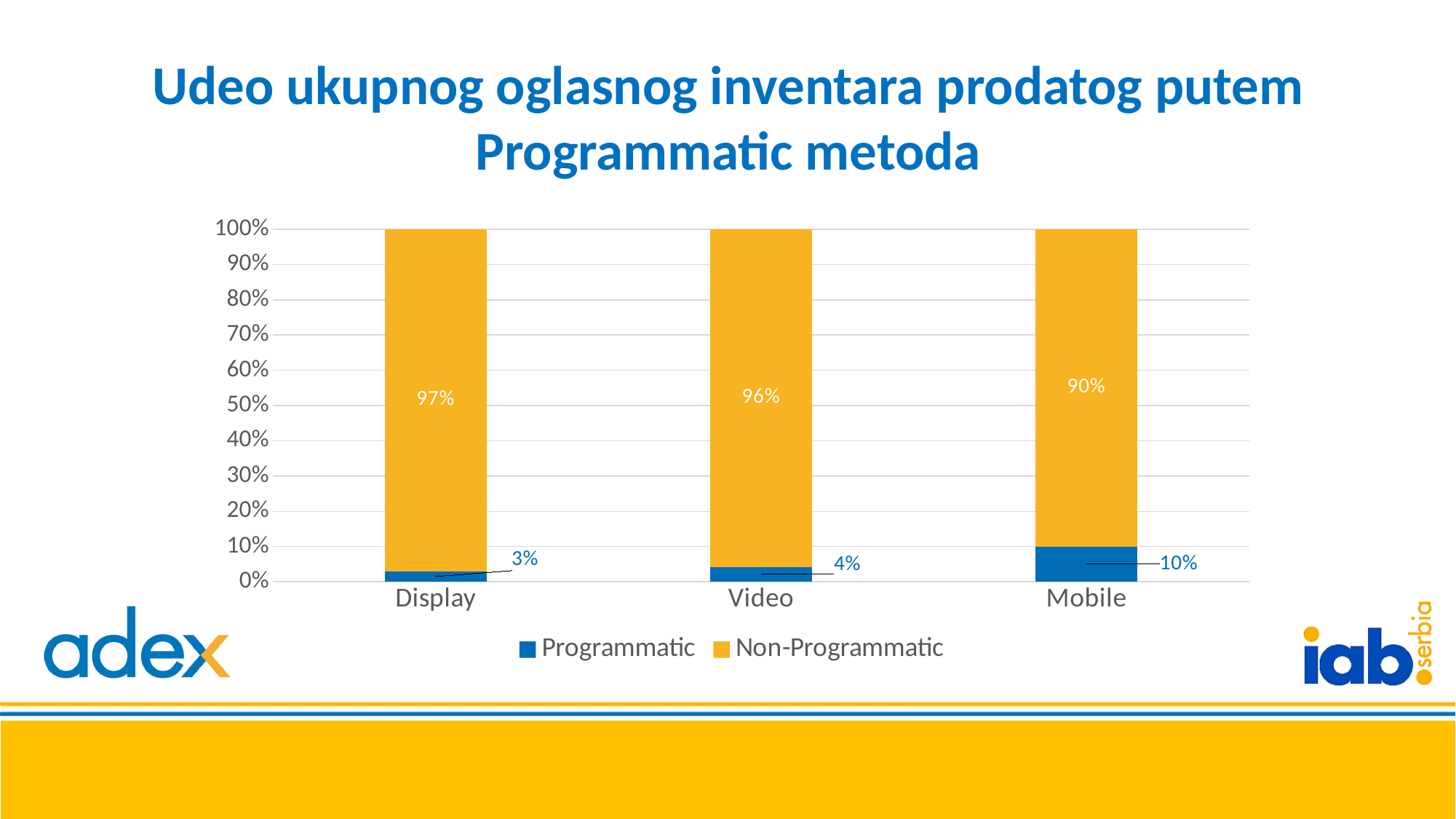
Which category has the highest Programmatic share? Mobile What is the difference between the Programmatic share for Mobile and for Display? 7% What is the total of the stacked bar for Video? 100% How many categories are shown on the x axis? 3 Which is larger, the Non-Programmatic share for Display or for Video? Display Which category has the lowest Programmatic share? Display How many series does the legend list? 2 What is the Programmatic share for Mobile? 10% What is the Programmatic share for Video? 4% What is the Non-Programmatic share for Display? 97% What kind of chart is shown on the slide? Stacked bar chart What is the Non-Programmatic share for Mobile? 90%